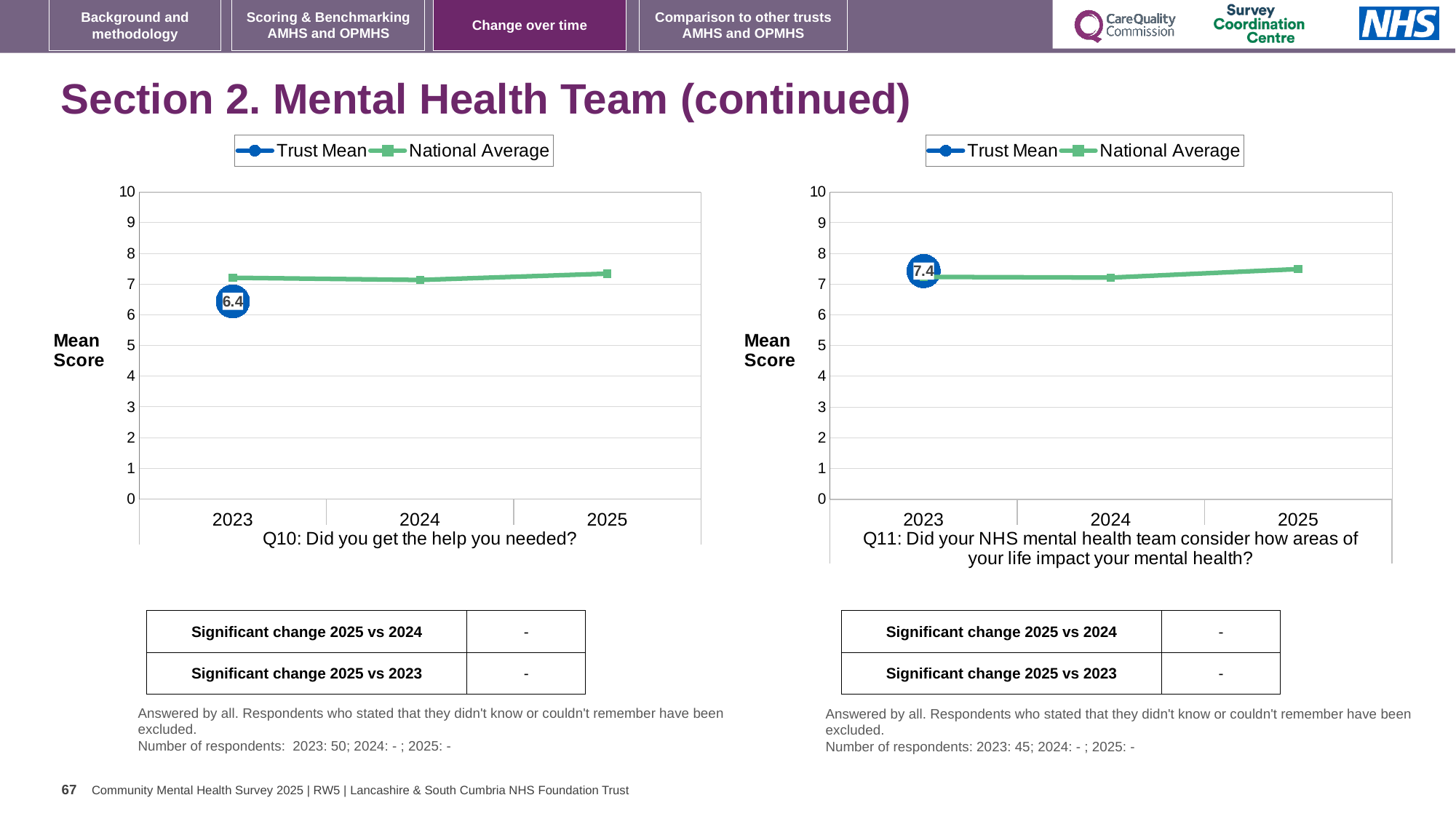
On the Q10 chart (left), what is the Trust Mean score for 2023? 6.4 How many years are shown on the x axis of the Q10 chart (left)? 3 What is the y-axis label on the Q11 chart (right)? Mean Score On the Q11 chart (right), does the National Average rise or fall from 2024 to 2025? rise On the Q11 chart (right), what is the Trust Mean score for 2023? 7.4 On the Q10 chart (left), is the National Average for 2025 greater or less than 8? less On the Q11 chart (right), is the National Average for 2025 greater or less than 7? greater How many series does the legend of the Q11 chart (right) list? 2 On the Q10 chart (left), is the Trust Mean for 2023 greater or less than the National Average for 2023? less What kind of chart is the Q10 chart on the left? Line chart What are the two legend entries on the Q10 chart (left)? Trust Mean and National Average On the Q10 chart (left), does the National Average rise or fall from 2024 to 2025? rise